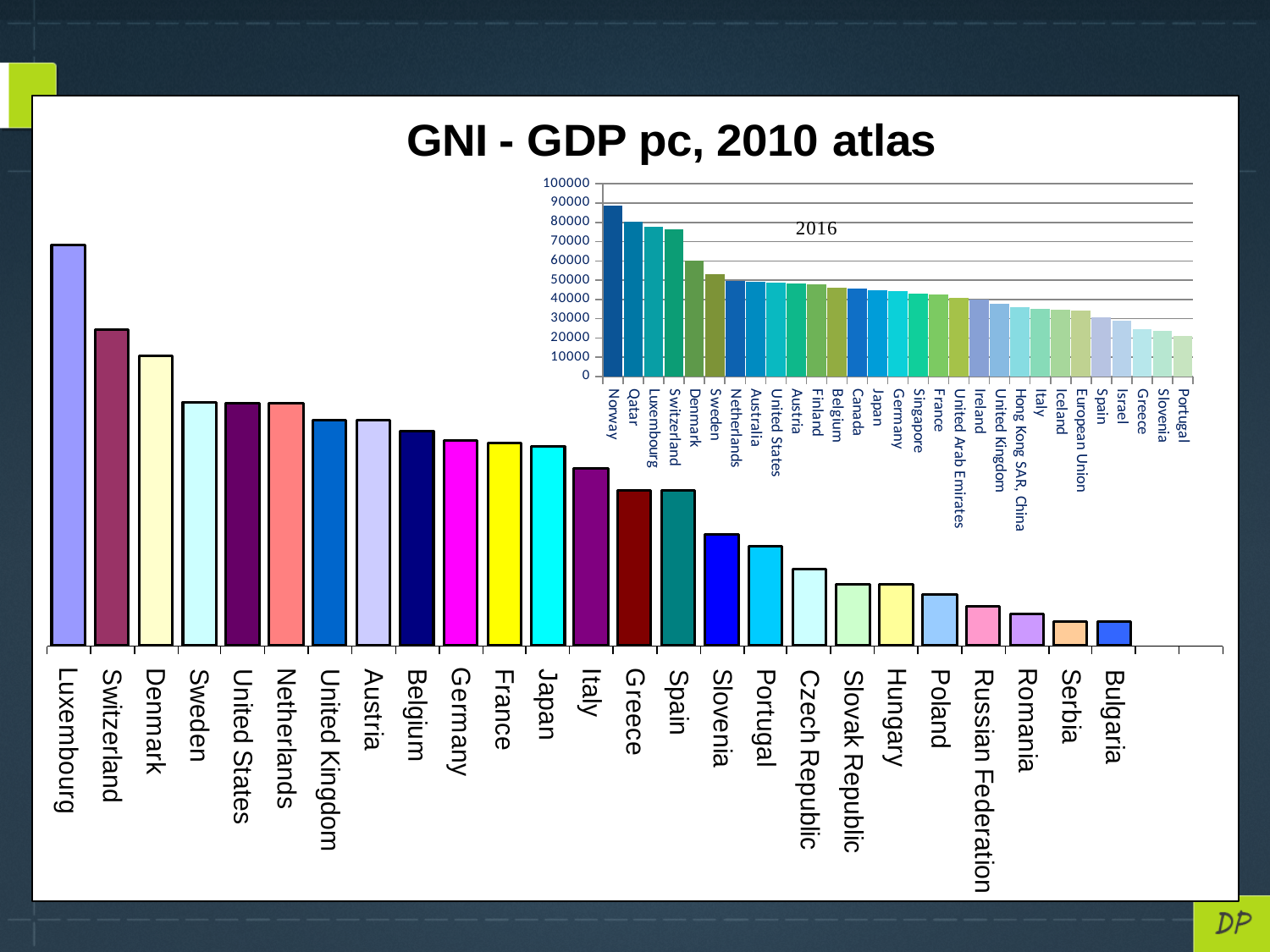
On the inset chart labelled '2016', is the value for Portugal greater or less than 30000? less On the large chart titled 'GNI - GDP pc, 2010 atlas', do the values rise or fall from left to right? fall On the inset chart labelled '2016', which country has the highest bar? Norway On the large chart titled 'GNI - GDP pc, 2010 atlas', which country has the highest bar? Luxembourg On the large chart titled 'GNI - GDP pc, 2010 atlas', which country has the lowest bar? Bulgaria On the inset chart labelled '2016', is the value for Norway greater or less than 80000? greater On the large chart titled 'GNI - GDP pc, 2010 atlas', how many countries are shown? 25 On the inset chart labelled '2016', which country has the lowest bar? Portugal On the large chart titled 'GNI - GDP pc, 2010 atlas', which is larger, the value for Switzerland or the value for Denmark? Switzerland On the inset chart labelled '2016', how many countries or regions are shown? 29 On the large chart titled 'GNI - GDP pc, 2010 atlas', which is larger, the value for Poland or the value for Czech Republic? Czech Republic What kind of chart is the large chart titled 'GNI - GDP pc, 2010 atlas'? bar chart